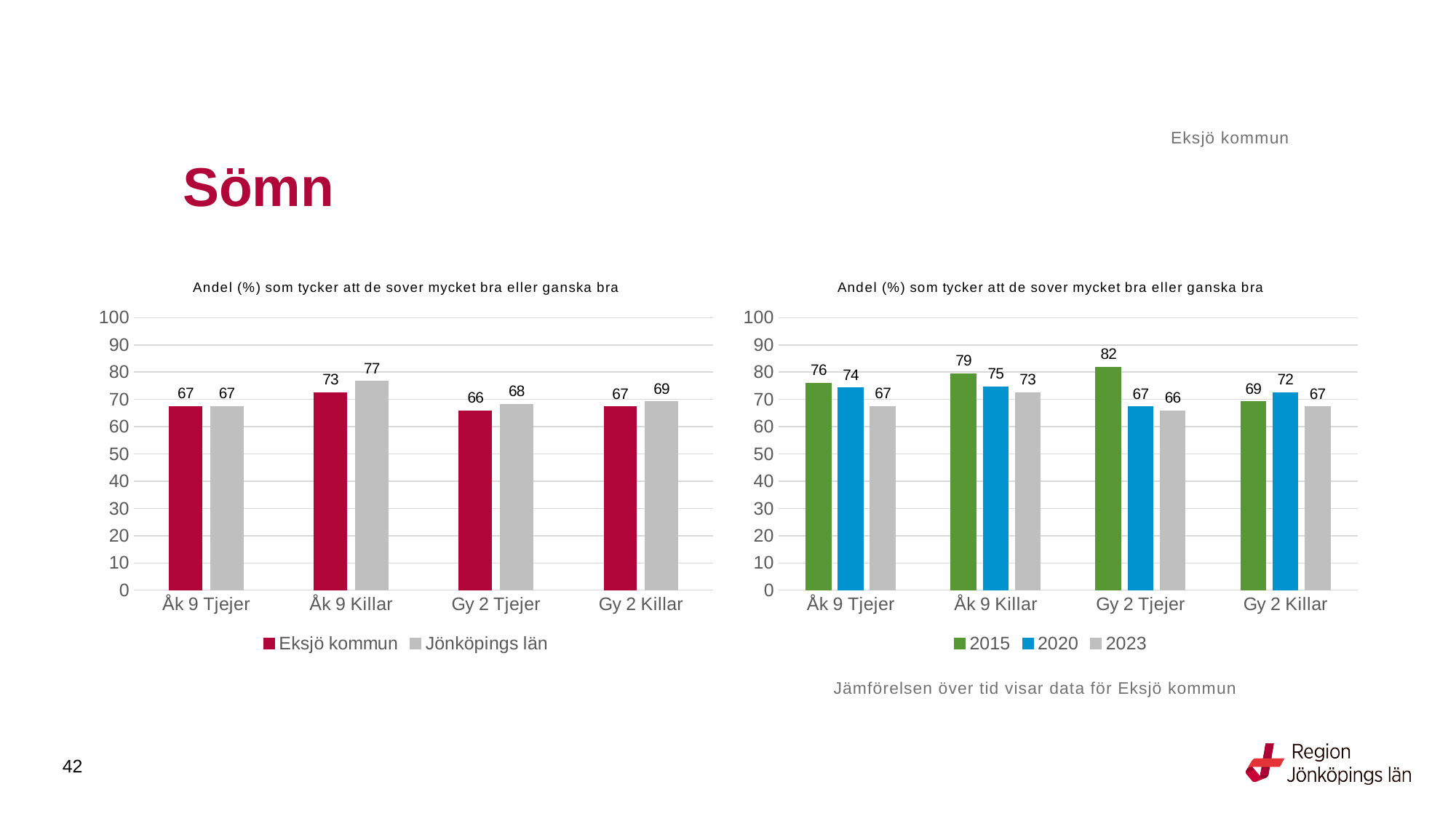
In the left chart, what is the value for Eksjö kommun for Åk 9 Killar? 73 In the left chart, what is the value for Jönköpings län for Gy 2 Tjejer? 68 In the left chart, what is the difference between Jönköpings län and Eksjö kommun for Åk 9 Killar? 4 What type of chart is the right chart? Bar chart In the right chart, how many series does the legend list? 3 In the right chart, what is the difference between the 2015 and 2023 values for Gy 2 Tjejer? 16 In the right chart, is the 2020 value for Gy 2 Killar larger than the 2015 value for Gy 2 Killar? Yes In the right chart, what is the value for 2023 for Åk 9 Killar? 73 In the right chart, which category has the lowest value for 2023? Gy 2 Tjejer In the left chart, how many series does the legend list? 2 In the right chart, what is the value for 2015 for Gy 2 Tjejer? 82 In the left chart, which category has the highest value for Jönköpings län? Åk 9 Killar